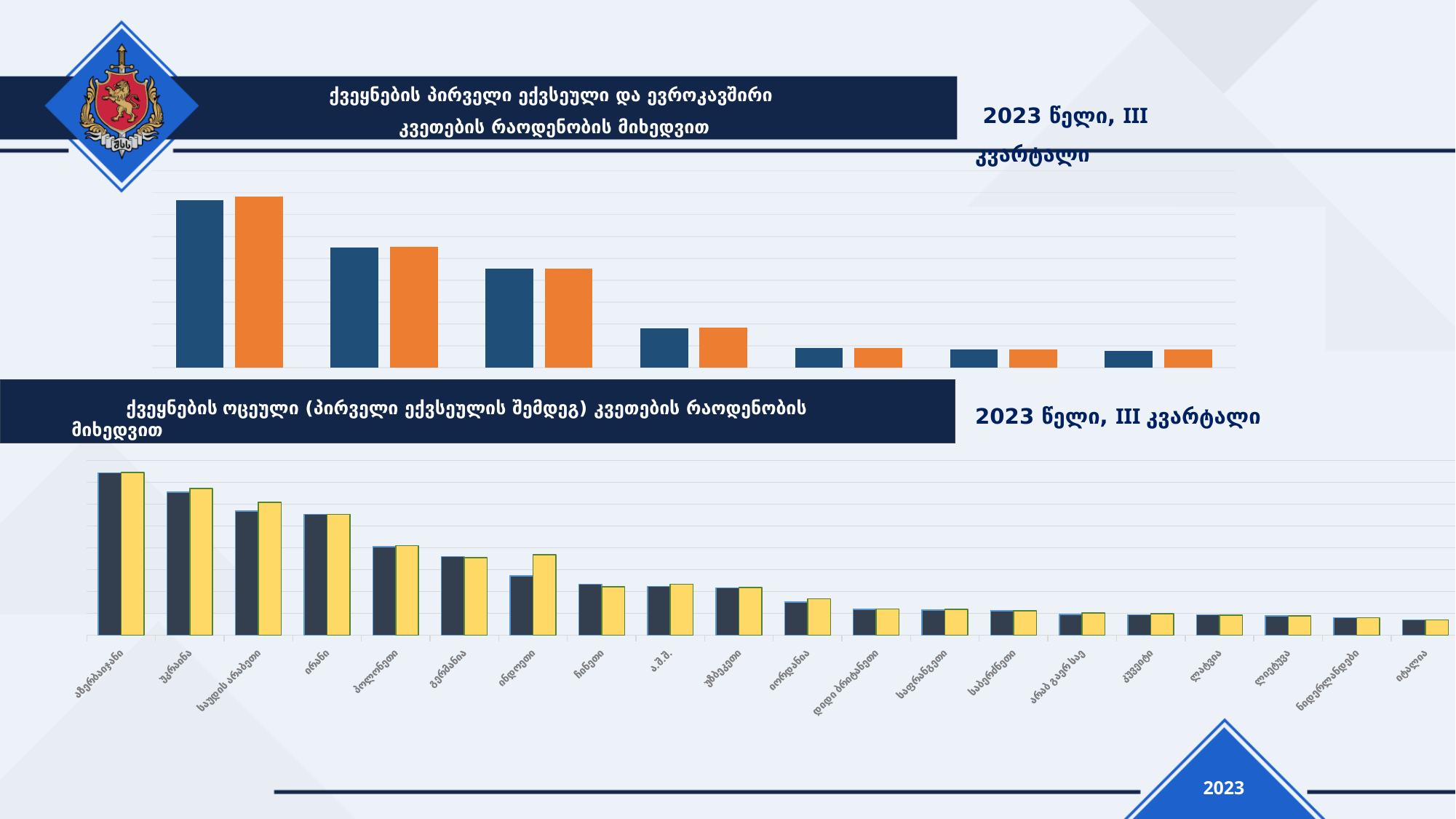
In the top chart, how many groups of bars (categories) are plotted? 7 In the bottom chart, how many bar colours (series) are shown for each category? 2 In the bottom chart, which is larger for ინდოეთი: the dark navy bar or the yellow bar? the yellow bar In the bottom chart, which category has the lowest bars? იტალია What kind of chart is the bottom chart on the slide? bar chart Which period (year and quarter) is stated next to the bottom chart's title? 2023 წელი, III კვარტალი In the bottom chart, which category has the highest bars? აზერბაიჯანი In the top chart, do the bar values rise or fall from left to right along the x axis? fall What kind of chart is the top chart on the slide? bar chart In the bottom chart, how many categories are plotted along the x axis? 20 In the bottom chart, which category has higher bars: აზერბაიჯანი or უკრაინა? აზერბაიჯანი In the top chart, how many bar colours (series) are shown for each category? 2